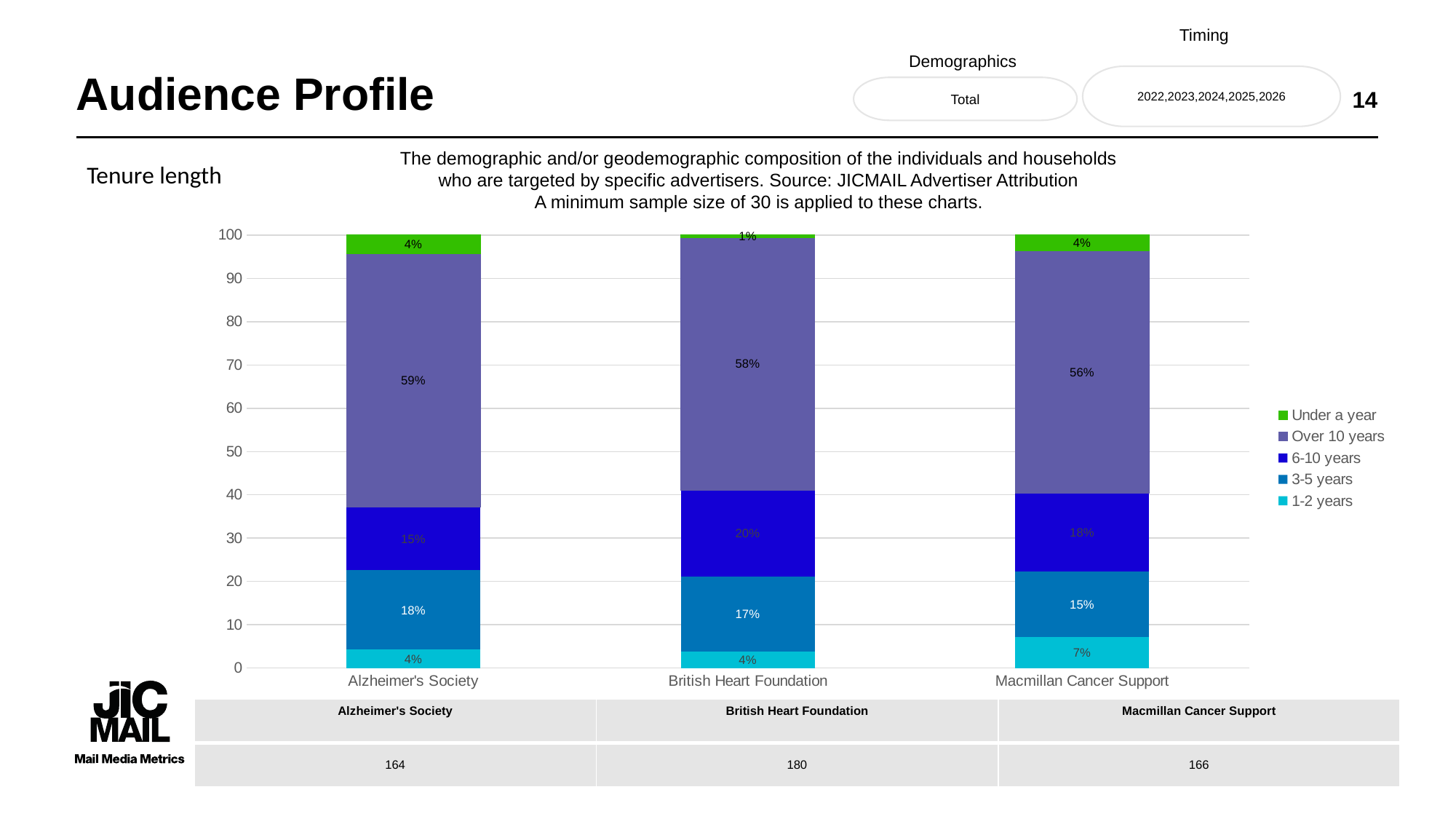
Which category has the highest value for Over 10 years? Alzheimer's Society What is the difference between the 3-5 years values for Alzheimer's Society and Macmillan Cancer Support? 3% What is the value for Over 10 years for Alzheimer's Society? 59% Which category has the lowest value for Under a year? British Heart Foundation How many categories are shown on the x axis? 3 What is the value for 1-2 years for Macmillan Cancer Support? 7% Which legend entry is shown in green? Under a year What kind of chart is shown on the slide? Stacked bar chart What is the value for 6-10 years for British Heart Foundation? 20% Which is larger: the 6-10 years value for Alzheimer's Society or for Macmillan Cancer Support? Macmillan Cancer Support What is the value for Under a year for British Heart Foundation? 1% How many series does the legend list? 5